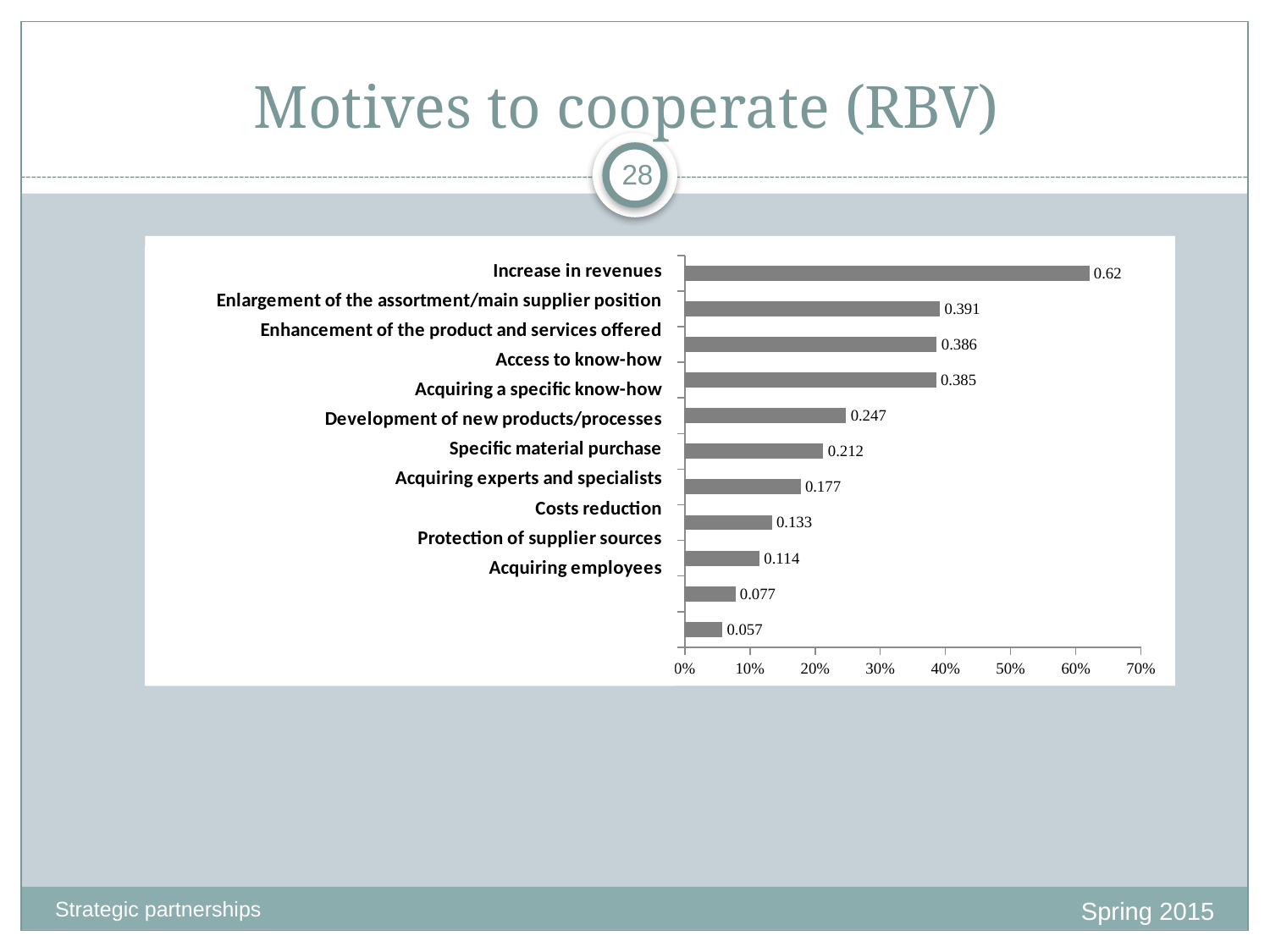
Which is larger, the value for Specific material purchase or the value for Acquiring experts and specialists? Specific material purchase How many motives (categories) are plotted in the chart? 11 Is the value for Development of new products/processes greater or less than 30%? less What is the value for Costs reduction? 0.114 What is the difference between the values for Increase in revenues and Enlargement of the assortment/main supplier position? 0.229 What is the title of the slide containing the chart? Motives to cooperate (RBV) What is the value for Development of new products/processes? 0.212 Which motive has the highest value? Increase in revenues Which motive has the lowest value? Acquiring employees What is the value for Increase in revenues? 0.62 What kind of chart is shown on the slide? bar chart What is the value for Acquiring employees? 0.057